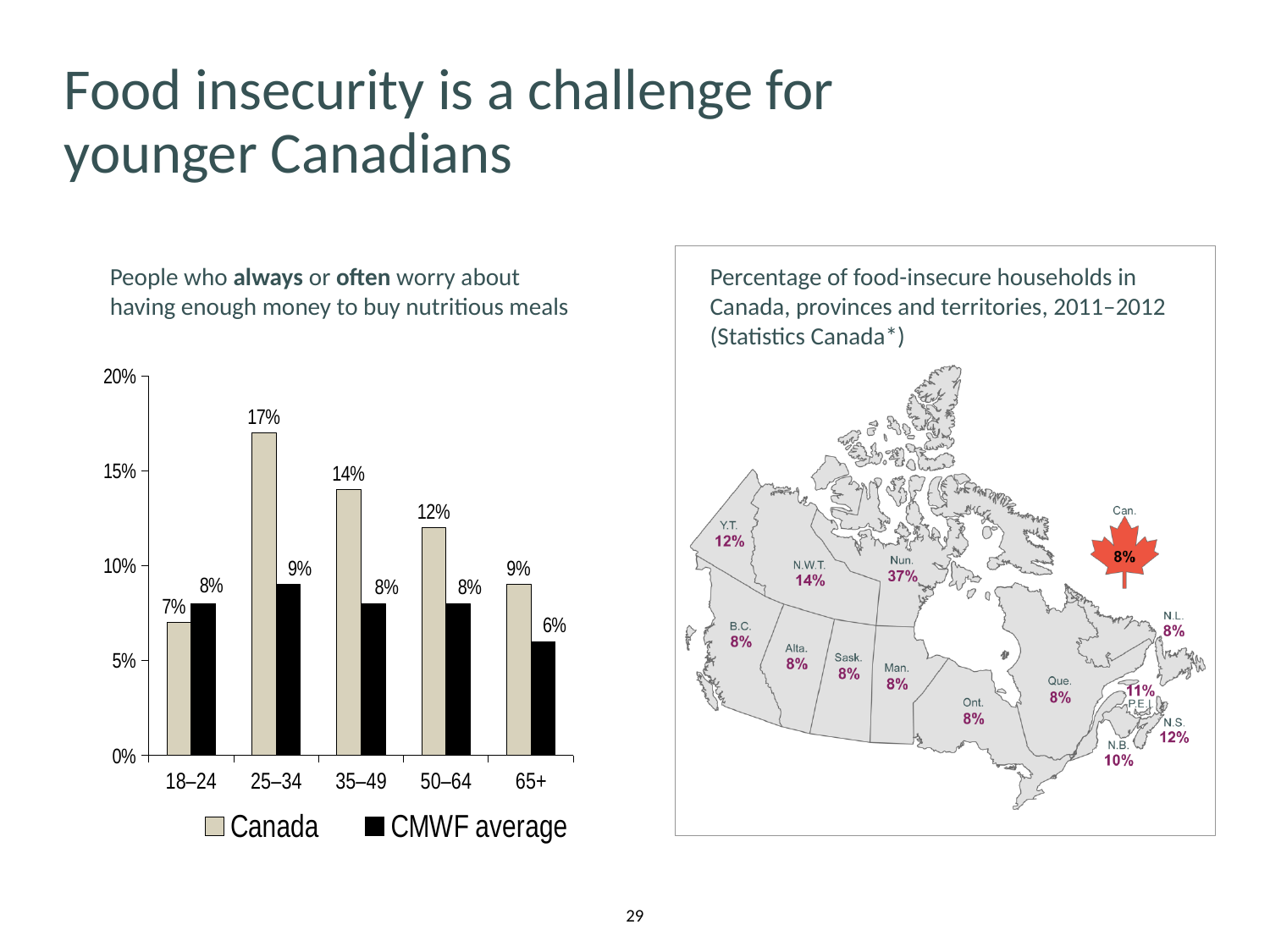
In the bar chart on the left, how many age groups are shown on the x axis? 5 What kind of chart is shown on the left of the slide? Bar chart In the bar chart on the left, what is the Canada value for the 25–34 age group? 17% In the bar chart on the left, how many series does the legend list? 2 In the bar chart on the left, what is the CMWF average value for the 65+ age group? 6% In the bar chart on the left, which age group has the lowest Canada value? 18–24 In the map on the right, which province or territory has the highest percentage of food-insecure households? Nun. In the bar chart on the left, which is larger for the 18–24 age group: Canada or CMWF average? CMWF average In the bar chart on the left, do the Canada values rise or fall from the 25–34 age group to the 65+ age group? Fall In the map on the right, what is the percentage of food-insecure households shown for Nunavut (Nun.)? 37% In the bar chart on the left, what is the difference between the Canada and CMWF average values for the 35–49 age group? 6% In the bar chart on the left, which age group has the highest Canada value? 25–34